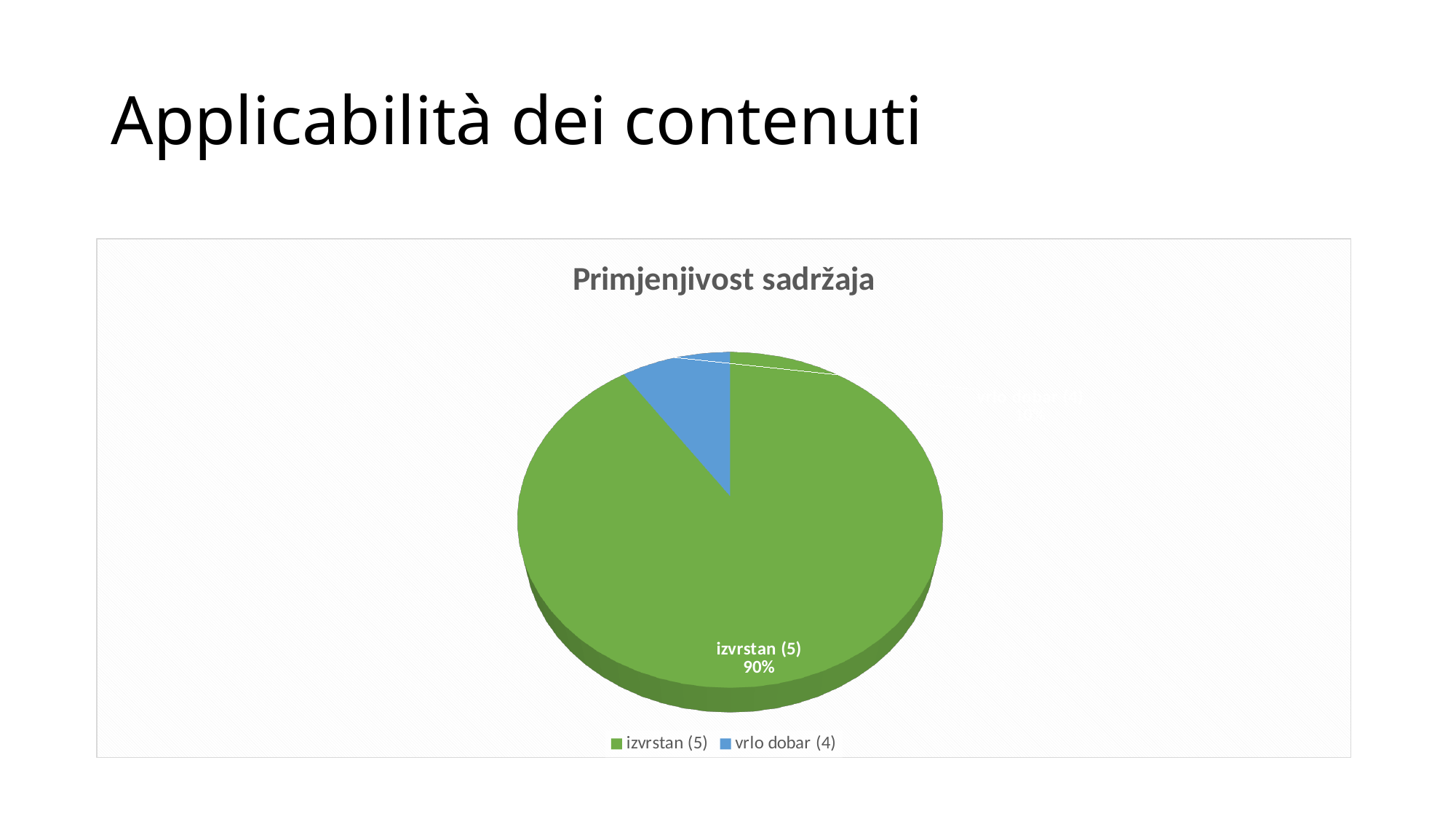
What kind of chart is shown on the slide? pie chart Which slice is larger, izvrstan (5) or vrlo dobar (4)? izvrstan (5) What is the title of the chart? Primjenjivost sadržaja What share of the pie does the vrlo dobar (4) slice have? 10% What share of the pie does the izvrstan (5) slice have? 90% Which category has the smallest slice of the pie? vrlo dobar (4) Which category has the largest slice of the pie? izvrstan (5) How many entries does the legend list? 2 How many slices does the pie chart have? 2 What colour is the izvrstan (5) slice? green